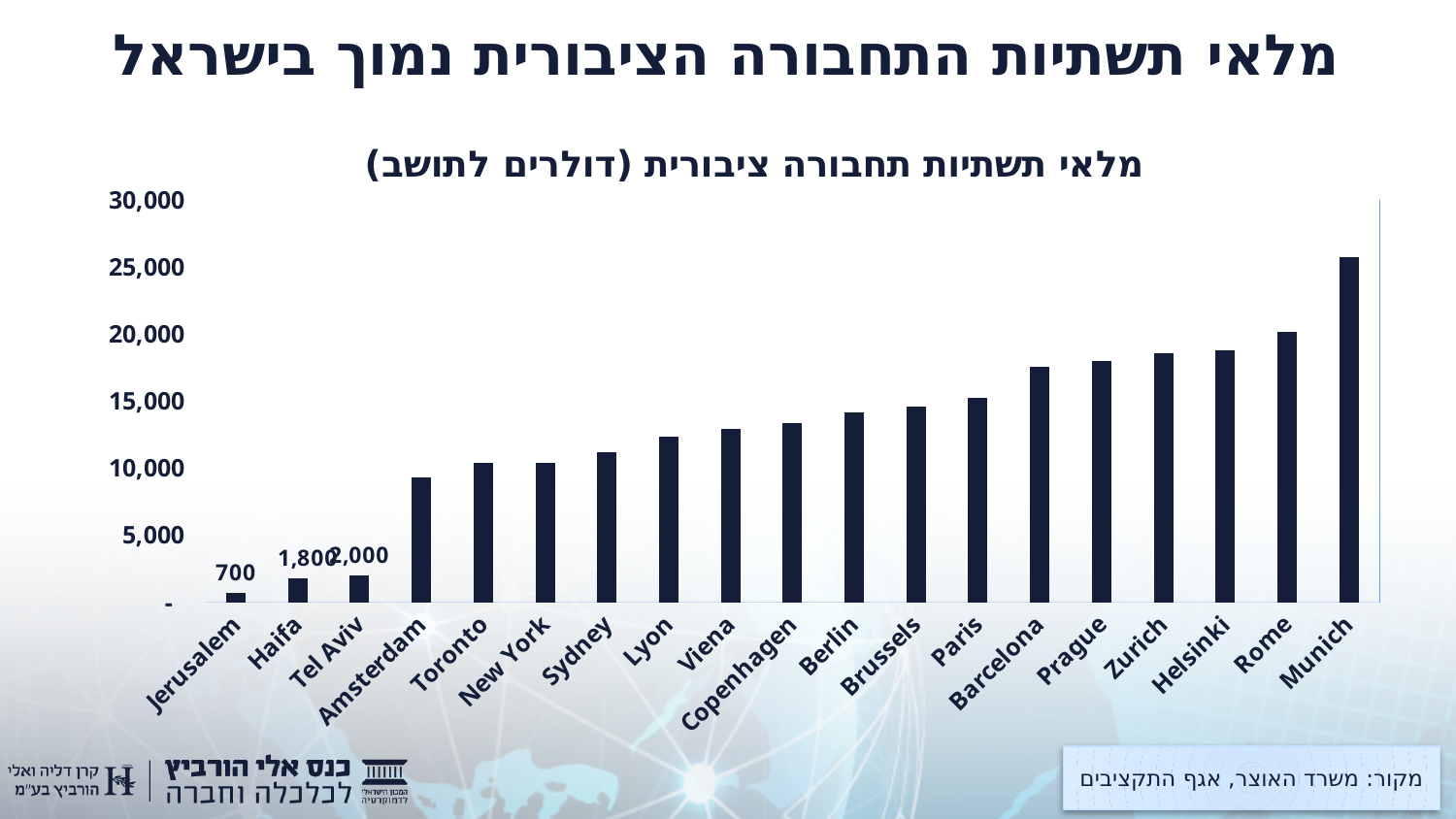
Is the value for Munich greater or less than 25,000? greater Which city has the lowest value? Jerusalem Which city has the highest value? Munich How many cities are shown on the chart? 19 Is the value for Amsterdam greater or less than 10,000? less What is the value for Jerusalem? 700 What is the value for Haifa? 1,800 What is the value for Tel Aviv? 2,000 Is the value for Barcelona greater or less than 15,000? greater Which is larger, the value for Tel Aviv or the value for Haifa? Tel Aviv What is the difference between the values for Tel Aviv and Jerusalem? 1,300 What kind of chart is shown on the slide? Bar chart